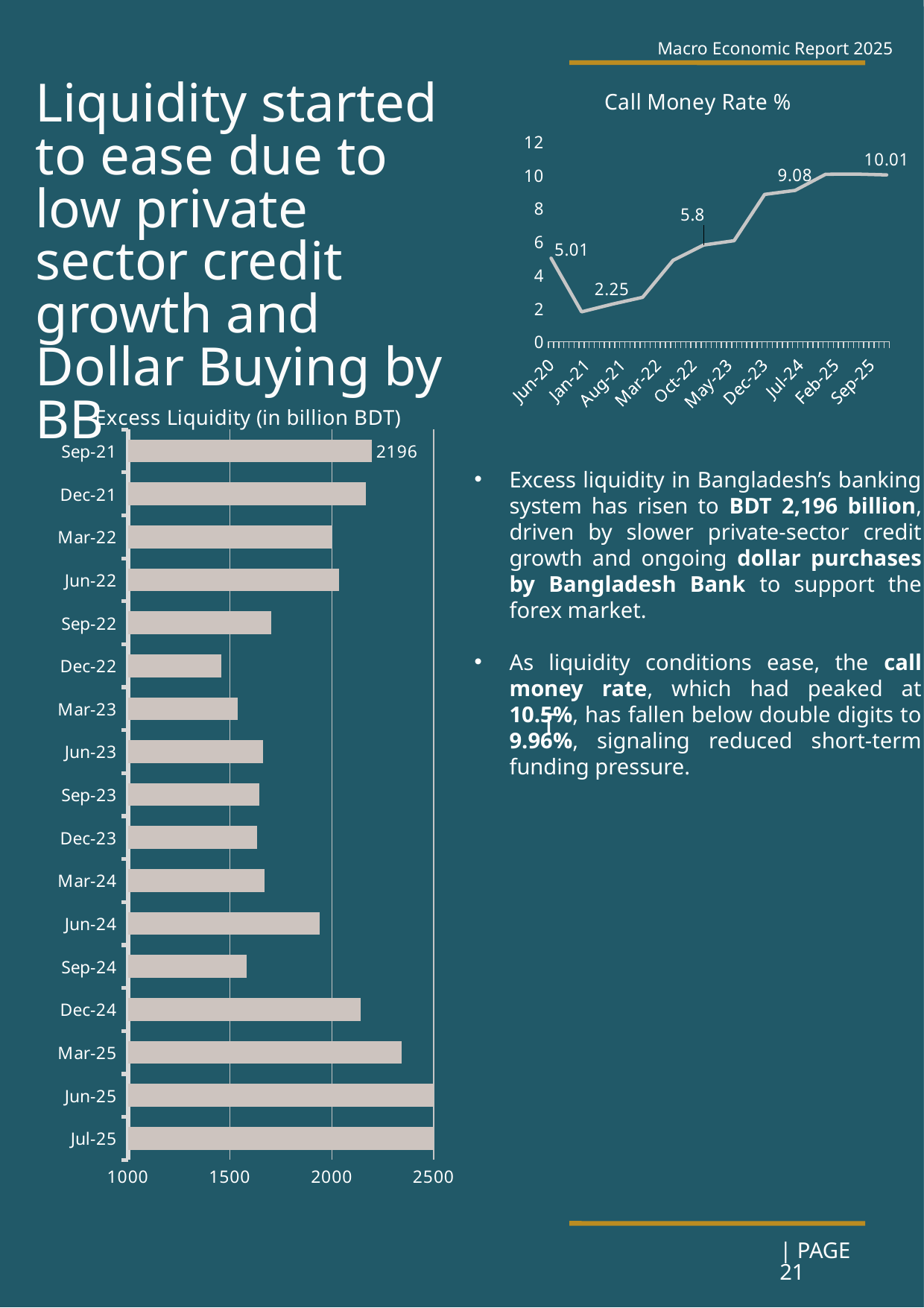
In the 'Excess Liquidity (in billion BDT)' chart, is the value for Dec-22 greater or less than 1500? less In the 'Call Money Rate %' chart, what is the difference between the highest labelled value (10.01) and the lowest labelled value (2.25)? 7.76 In the 'Call Money Rate %' chart, what is the highest labelled value? 10.01 In the 'Excess Liquidity (in billion BDT)' chart, what is the value for Sep-21? 2196 In the 'Excess Liquidity (in billion BDT)' chart, is the value for Mar-25 greater or less than 2000? greater What type of chart is the 'Excess Liquidity (in billion BDT)' chart? bar chart What type of chart is the 'Call Money Rate %' chart? line chart In the 'Excess Liquidity (in billion BDT)' chart, which is larger, the value for Mar-25 or the value for Dec-24? Mar-25 In the 'Excess Liquidity (in billion BDT)' chart, is the value for Jun-24 greater or less than 2000? less In the 'Excess Liquidity (in billion BDT)' chart, which category has the lowest value? Dec-22 How many categories are shown on the 'Excess Liquidity (in billion BDT)' chart? 17 In the 'Call Money Rate %' chart, what is the lowest labelled value? 2.25